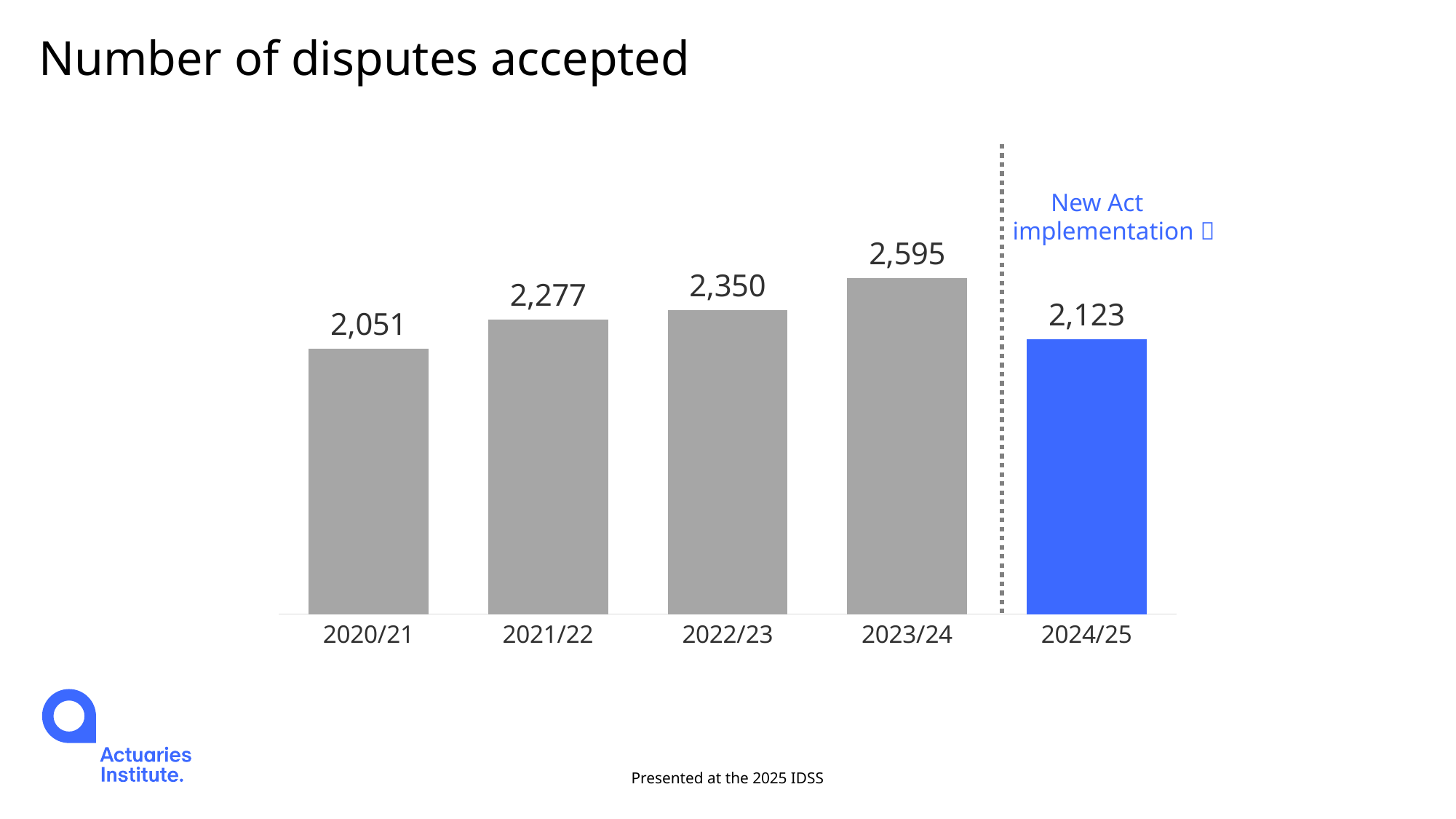
What is the number of disputes accepted in 2022/23? 2,350 What event does the dotted line on the chart mark before the 2024/25 bar? New Act implementation What is the difference in disputes accepted between 2021/22 and 2020/21? 226 What is the difference in disputes accepted between 2023/24 and 2024/25? 472 How many years are shown on the chart? 5 What kind of chart is shown on the slide? Bar chart What is the number of disputes accepted in 2023/24? 2,595 What is the number of disputes accepted in 2020/21? 2,051 Which year has the lowest number of disputes accepted? 2020/21 Which year has the highest number of disputes accepted? 2023/24 What is the number of disputes accepted in 2024/25? 2,123 Which year had more disputes accepted, 2021/22 or 2024/25? 2021/22